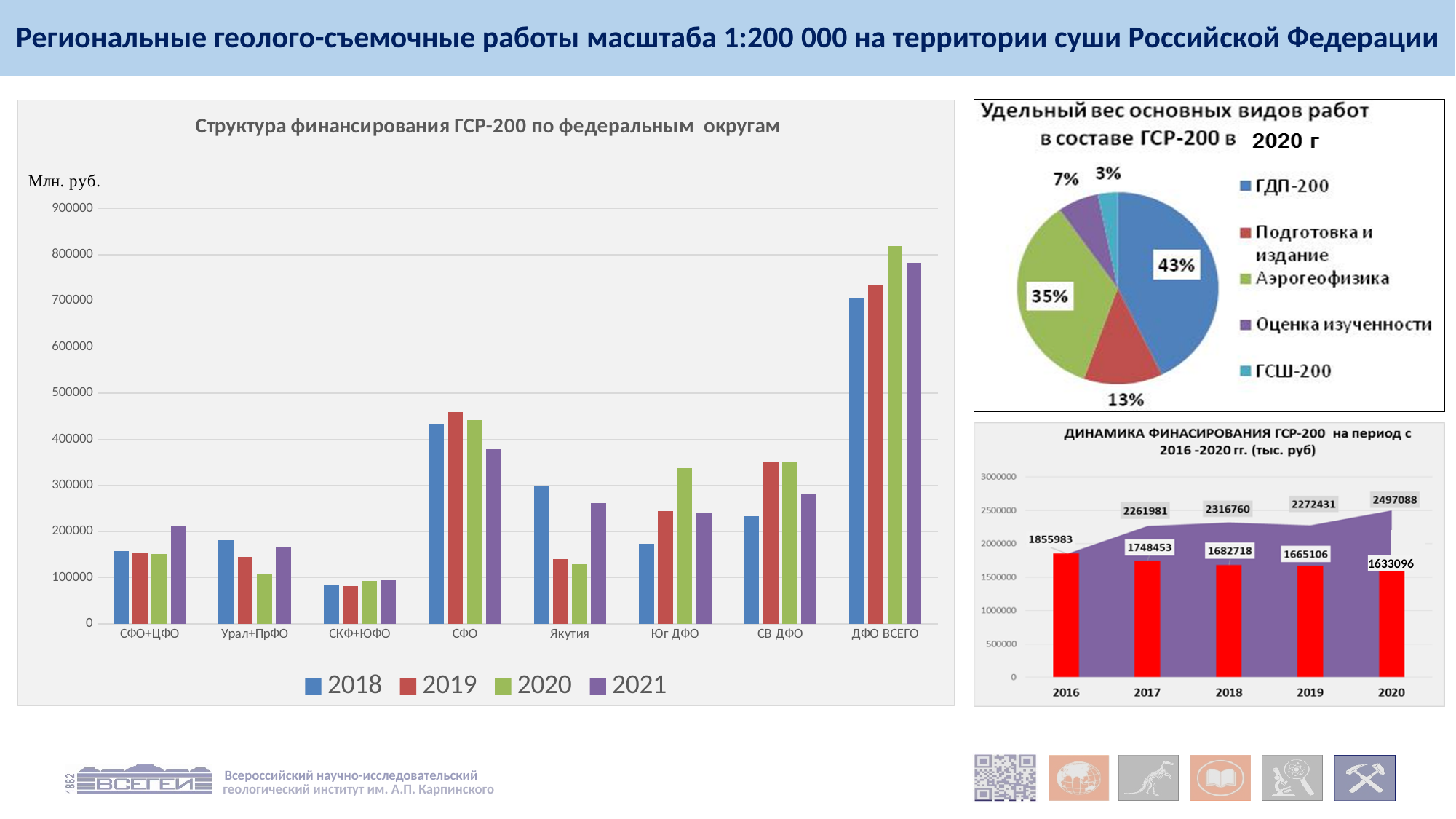
In the chart 'Структура финансирования ГСР-200 по федеральным округам', which is larger for Якутия: the 2018 value or the 2019 value? 2018 In the chart 'ДИНАМИКА ФИНАСИРОВАНИЯ ГСР-200 на период с 2016-2020 гг.', what is the difference between the red bar values for 2016 and 2020? 222887 In the pie chart 'Удельный вес основных видов работ в составе ГСР-200 в 2020 г', which category has the smallest slice? ГСШ-200 In the chart 'Структура финансирования ГСР-200 по федеральным округам', how many series does the legend list? 4 In the chart 'ДИНАМИКА ФИНАСИРОВАНИЯ ГСР-200 на период с 2016-2020 гг.', what is the value of the red bar for 2020? 1633096 In the chart 'Структура финансирования ГСР-200 по федеральным округам', which category has the highest 2020 value? ДФО ВСЕГО In the pie chart 'Удельный вес основных видов работ в составе ГСР-200 в 2020 г', what share does ГДП-200 have? 43% In the chart 'Структура финансирования ГСР-200 по федеральным округам', is the 2018 value for СКФ+ЮФО greater or less than 100000? less In the pie chart 'Удельный вес основных видов работ в составе ГСР-200 в 2020 г', what is the share of Аэрогеофизика? 35% In the chart 'Структура финансирования ГСР-200 по федеральным округам', how many categories are shown on the x axis? 8 In the pie chart 'Удельный вес основных видов работ в составе ГСР-200 в 2020 г', how many slices are there? 5 What kind of chart is 'Структура финансирования ГСР-200 по федеральным округам'? bar chart